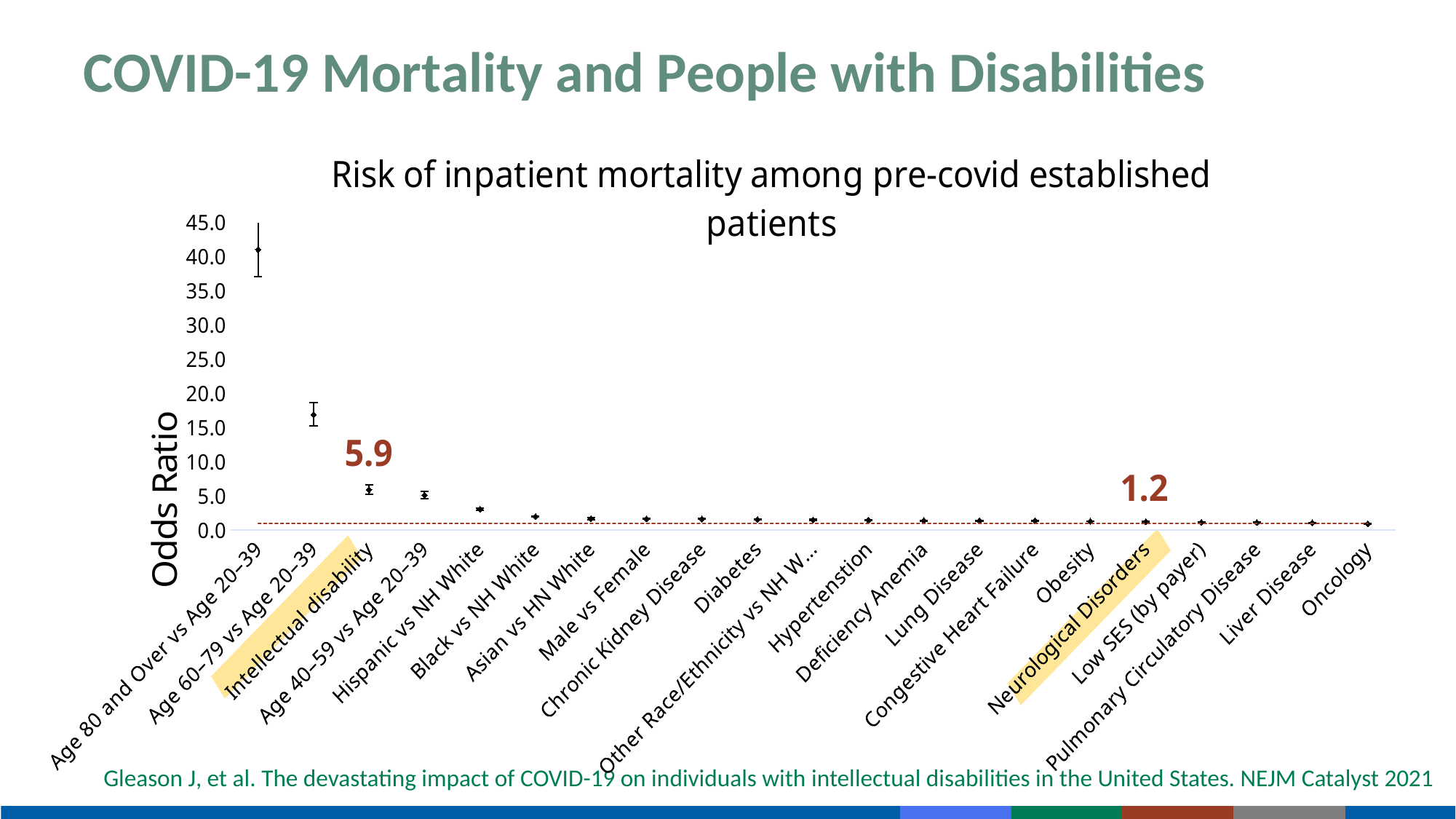
Is the odds ratio for Age 60–79 vs Age 20–39 greater or less than 20.0? less Do the odds ratios rise or fall moving from left to right along the x axis? fall What is the odds ratio shown for Neurological Disorders? 1.2 How many categories are plotted on the x axis? 21 Which two category labels are highlighted in yellow? Intellectual disability and Neurological Disorders Is the odds ratio for Age 80 and Over vs Age 20–39 greater or less than 35.0? greater What is the difference between the odds ratios labelled for Intellectual disability and Neurological Disorders? 4.7 What is the title of the y axis? Odds Ratio What is the odds ratio shown for Intellectual disability? 5.9 Is the odds ratio for Age 40–59 vs Age 20–39 greater or less than 10.0? less Which has the larger odds ratio, Intellectual disability or Age 60–79 vs Age 20–39? Age 60–79 vs Age 20–39 Which category has the highest odds ratio? Age 80 and Over vs Age 20–39